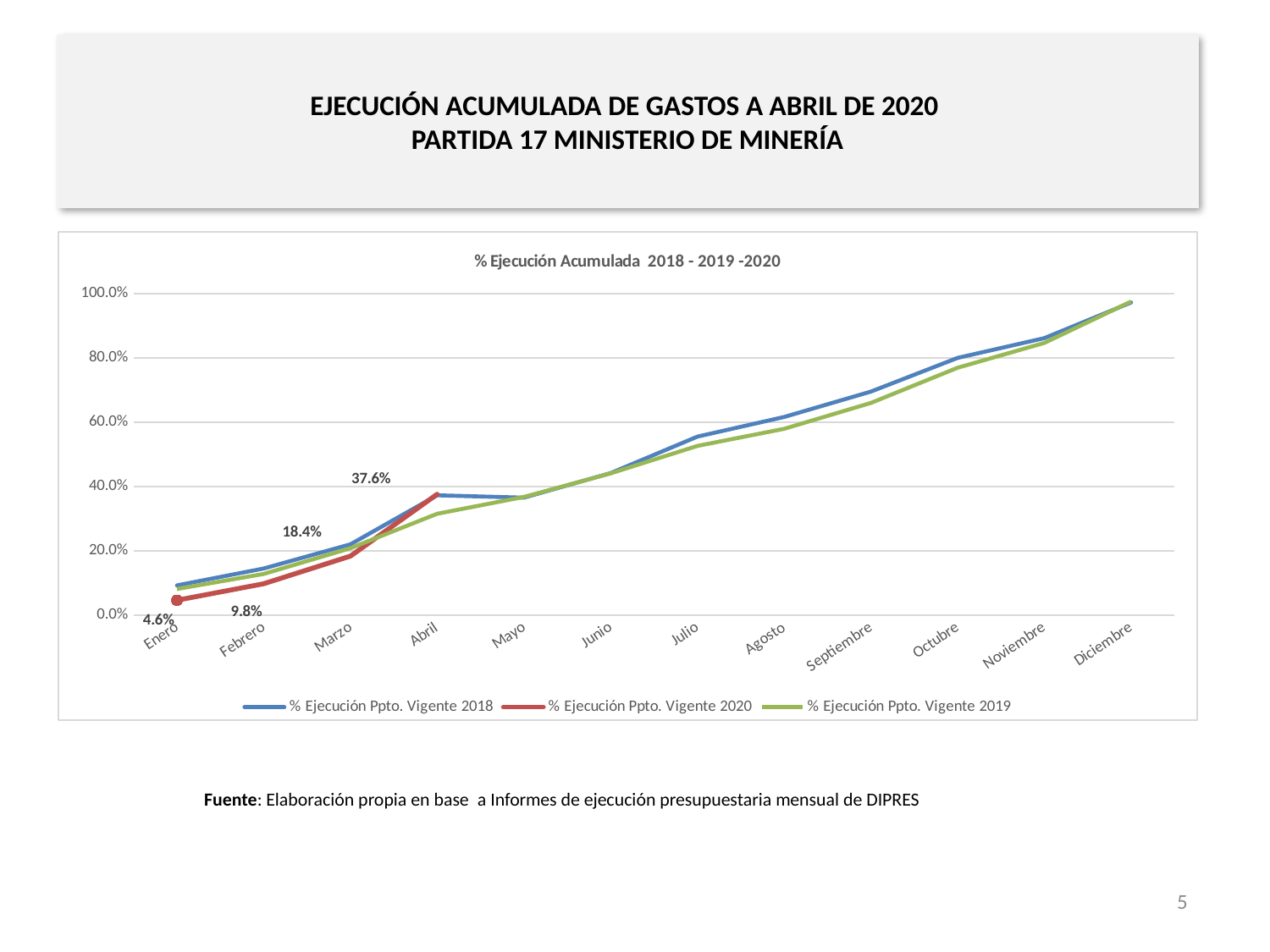
What is the value of % Ejecución Ppto. Vigente 2020 for Marzo? 18.4% Is the value for % Ejecución Ppto. Vigente 2019 in Abril greater or less than 40.0%? less Do the values for % Ejecución Ppto. Vigente 2018 rise or fall from Enero to Diciembre? Rise How many series does the legend list? 3 What is the value of % Ejecución Ppto. Vigente 2020 for Enero? 4.6% By how many percentage points did % Ejecución Ppto. Vigente 2020 increase from Marzo to Abril? 19.2 What kind of chart is shown? Line chart How many months are shown on the x axis? 12 What is the value of % Ejecución Ppto. Vigente 2020 for Febrero? 9.8% Which month has the highest labelled value for % Ejecución Ppto. Vigente 2020? Abril What is the title of the chart? % Ejecución Acumulada 2018 - 2019 -2020 What is the value of % Ejecución Ppto. Vigente 2020 for Abril? 37.6%